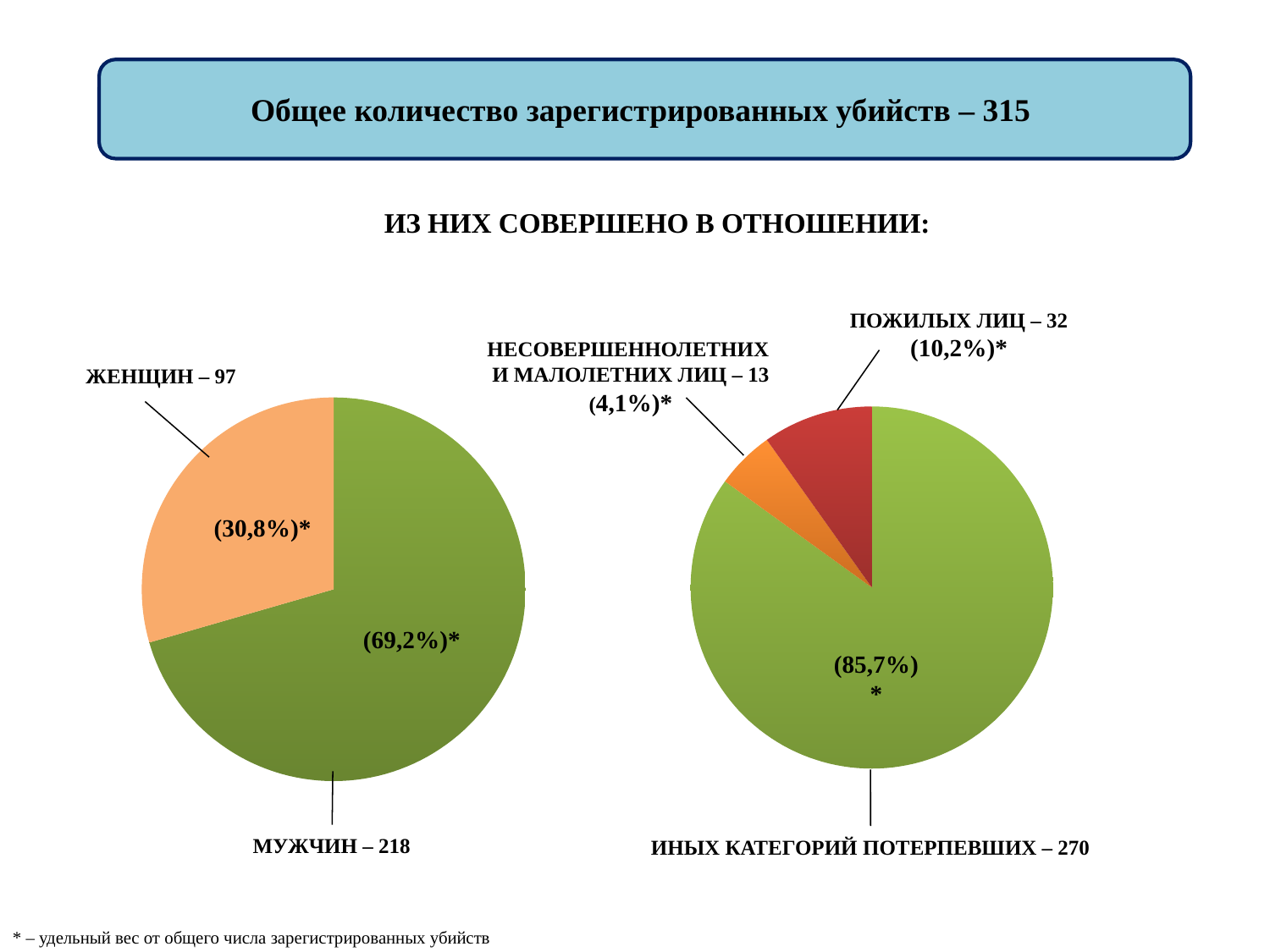
How many slices does the right pie chart have? 3 In the right pie chart, what is the difference between the number of murders of elderly persons and of minors? 19 In the right pie chart, how many murders were committed against elderly persons (ПОЖИЛЫХ ЛИЦ)? 32 In the right pie chart, what share do murders of minors (НЕСОВЕРШЕННОЛЕТНИХ И МАЛОЛЕТНИХ ЛИЦ) represent? 4,1% In the left pie chart, how many murders were committed against women (ЖЕНЩИН)? 97 In the left pie chart, what share of the total do murders of men (МУЖЧИН) represent? 69,2% In the right pie chart, which category has the largest value? ИНЫХ КАТЕГОРИЙ ПОТЕРПЕВШИХ In the left pie chart, what is the difference between the number of murders of men and of women? 121 In the right pie chart, which category has the smallest value? НЕСОВЕРШЕННОЛЕТНИХ И МАЛОЛЕТНИХ ЛИЦ In the left pie chart, which category is larger: ЖЕНЩИН or МУЖЧИН? МУЖЧИН In the left pie chart, how many murders were committed against men (МУЖЧИН)? 218 What type of chart is the left chart on the slide? pie chart